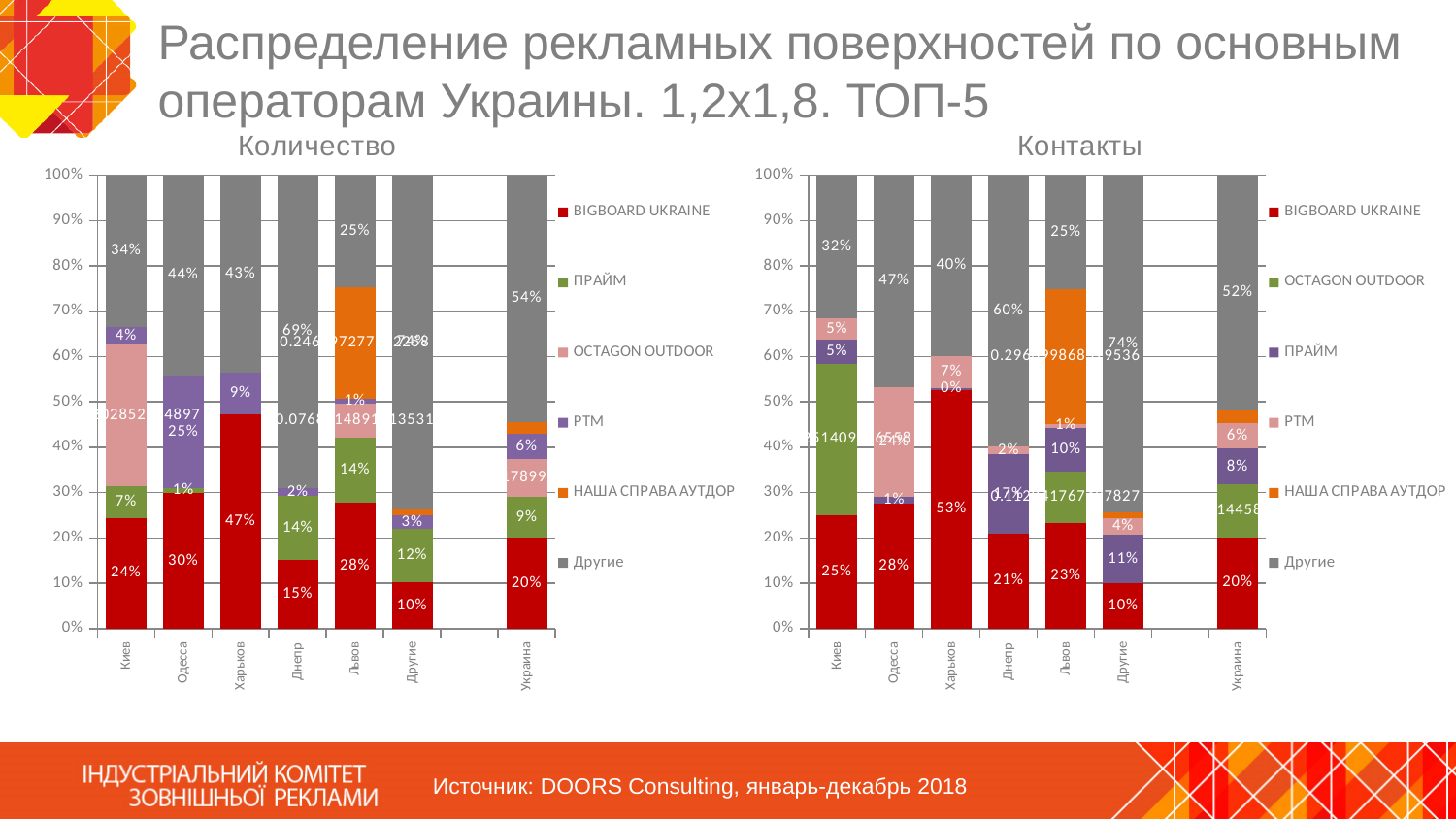
In the right chart (Контакты), what is the value for Другие (the grey series) in Днепр? 60% How many categories are shown on the x axis of the left chart (Количество)? 7 In the left chart (Количество), which city has the highest BIGBOARD UKRAINE share? Харьков In the left chart (Количество), what is the value for BIGBOARD UKRAINE in Харьков? 47% In the right chart (Контакты), what is the difference between the BIGBOARD UKRAINE share in Харьков and in Киев? 28% What is the title of the right chart? Контакты In the left chart (Количество), which category has the lowest BIGBOARD UKRAINE share? Другие In the left chart (Количество), what is the value for Другие (the grey series) in Украина? 54% What type of chart is the left chart (Количество)? Stacked bar chart In the left chart (Количество), which is larger: the BIGBOARD UKRAINE share in Одесса or in Львов? Одесса How many series does the legend of the right chart (Контакты) list? 6 In the right chart (Контакты), what is the value for BIGBOARD UKRAINE in Харьков? 53%